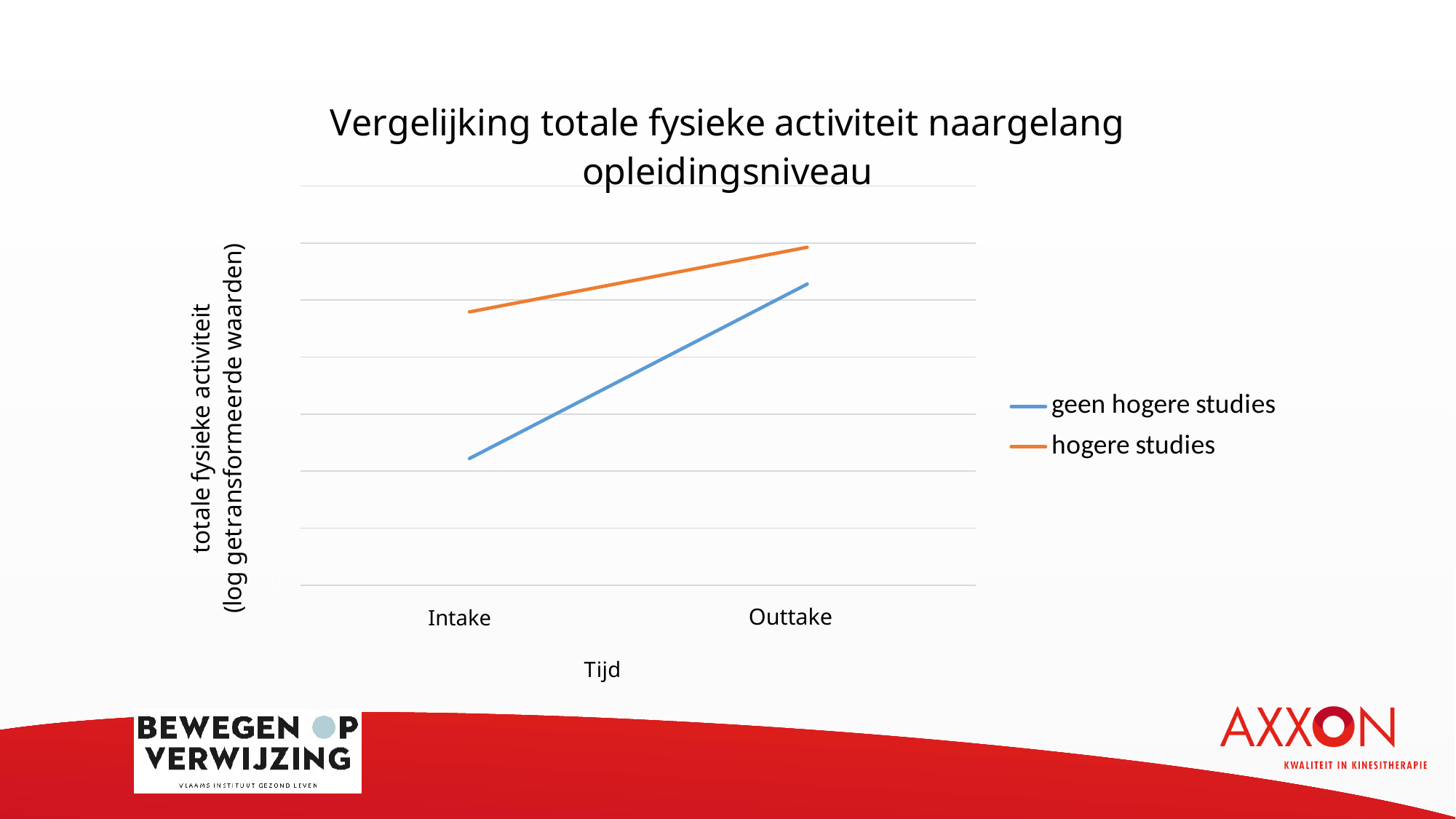
How many time points are shown on the x axis? 2 At Intake, which series has the higher value: 'geen hogere studies' or 'hogere studies'? hogere studies Which series reaches the highest value on the chart? hogere studies How many series does the legend list? 2 What are the two categories on the x axis? Intake and Outtake Which series shows the steeper increase between Intake and Outtake? geen hogere studies Which series has the lowest value on the chart? geen hogere studies At Outtake, which series has the higher value: 'geen hogere studies' or 'hogere studies'? hogere studies Does the value for 'hogere studies' rise or fall from Intake to Outtake? rise What is the label of the x axis? Tijd Does the value for 'geen hogere studies' rise or fall from Intake to Outtake? rise What kind of chart is shown on the slide? line chart